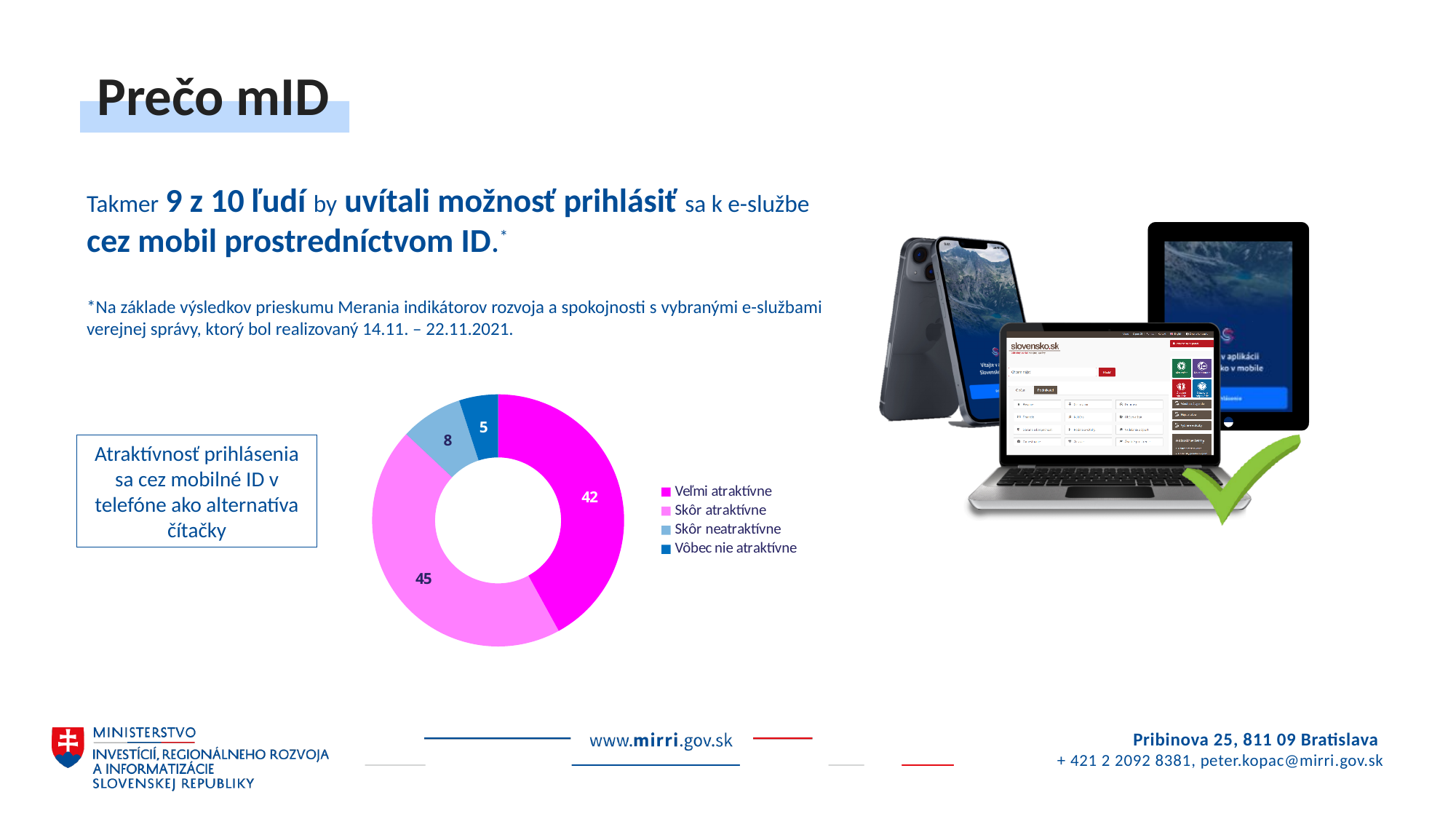
What value is shown for the "Skôr atraktívne" slice of the doughnut chart? 45 What value is shown for the "Veľmi atraktívne" slice of the doughnut chart? 42 Which is larger in the doughnut chart: the value for "Skôr neatraktívne" or for "Vôbec nie atraktívne"? Skôr neatraktívne What type of chart is shown on the slide? Doughnut (pie) chart How many categories does the doughnut chart show? 4 Which category has the smallest slice in the doughnut chart? Vôbec nie atraktívne Which category has the largest slice in the doughnut chart? Skôr atraktívne What is the difference between the values for "Skôr atraktívne" and "Veľmi atraktívne" in the doughnut chart? 3 What value is shown for the "Skôr neatraktívne" slice of the doughnut chart? 8 Which colour represents "Vôbec nie atraktívne" in the doughnut chart legend? Dark blue What is the combined value of the "Veľmi atraktívne" and "Skôr atraktívne" slices in the doughnut chart? 87 What value is shown for the "Vôbec nie atraktívne" slice of the doughnut chart? 5